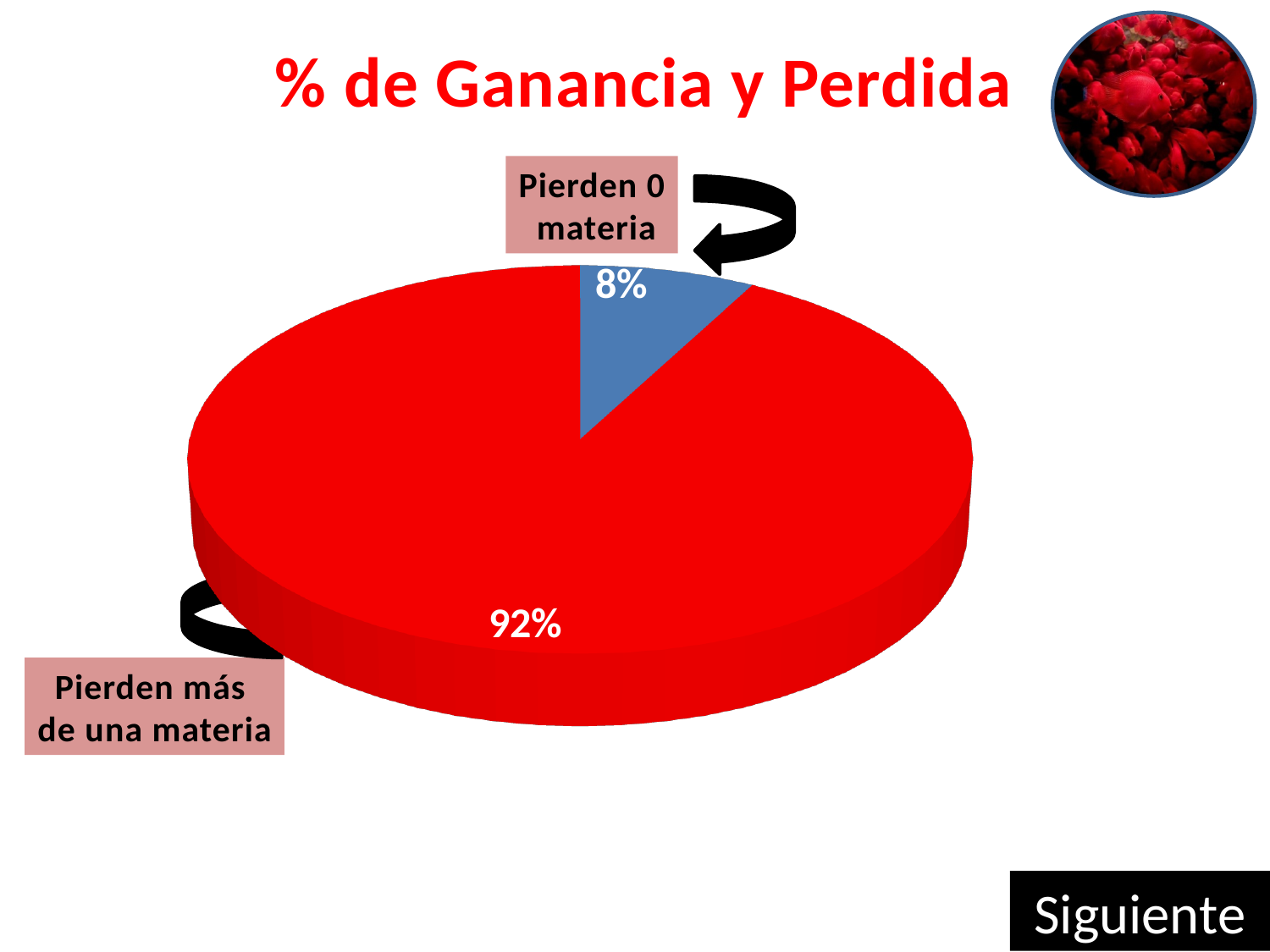
How many slices does the pie chart have? 2 What colour is the slice for "Pierden 0 materia"? blue Which slice is the smallest? Pierden 0 materia What percentage is shown for "Pierden 0 materia"? 8% Which is larger, the share for "Pierden 0 materia" or the share for "Pierden más de una materia"? Pierden más de una materia What is the difference in percentage points between "Pierden más de una materia" and "Pierden 0 materia"? 84 What kind of chart is shown on the slide? pie chart What share of the pie does "Pierden más de una materia" represent? 92% What is the title of the chart? % de Ganancia y Perdida What percentage is shown for "Pierden más de una materia"? 92% Which slice is the largest? Pierden más de una materia